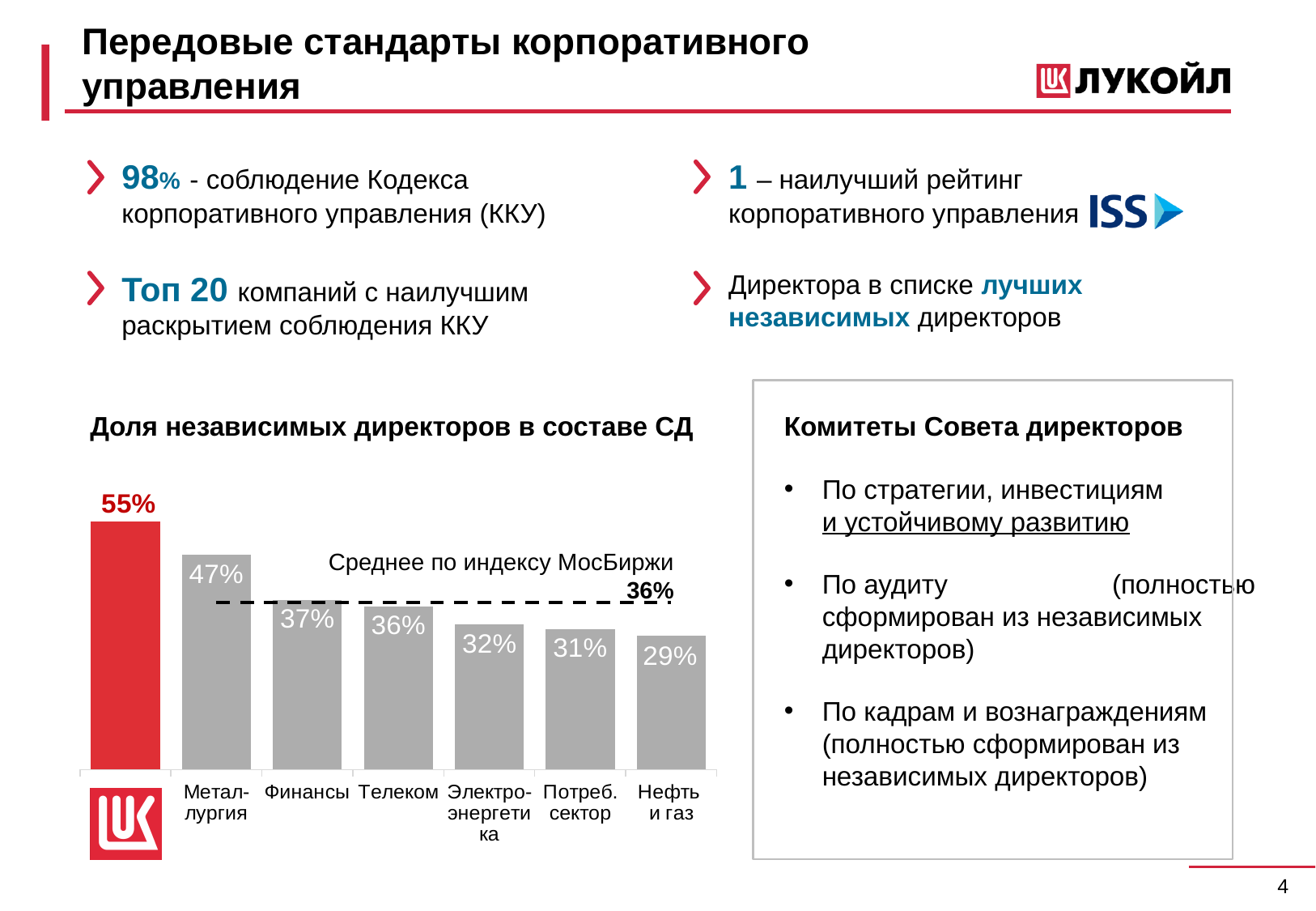
How many bars are shown in the chart "Доля независимых директоров в составе СД"? 7 Do the values rise or fall from left to right in the chart "Доля независимых директоров в составе СД"? fall What is the value for Металлургия in the chart "Доля независимых директоров в составе СД"? 47% Which is larger in the chart "Доля независимых директоров в составе СД": the value for Телеком or the value for Потреб. сектор? Телеком What is the value for Электроэнергетика in the chart "Доля независимых директоров в составе СД"? 32% What is the difference between the value for Металлургия and the value for Нефть и газ in the chart "Доля независимых директоров в составе СД"? 18% What type of chart is shown under the title "Доля независимых директоров в составе СД"? bar chart Which category has the lowest value in the chart "Доля независимых директоров в составе СД"? Нефть и газ What value does the dashed line labelled "Среднее по индексу МосБиржи" mark in the chart "Доля независимых директоров в составе СД"? 36% What is the value for Финансы in the chart "Доля независимых директоров в составе СД"? 37% What is the value for Нефть и газ in the chart "Доля независимых директоров в составе СД"? 29% Which bar has the highest value in the chart "Доля независимых директоров в составе СД"? the red bar with the ЛУКОЙЛ logo (55%)